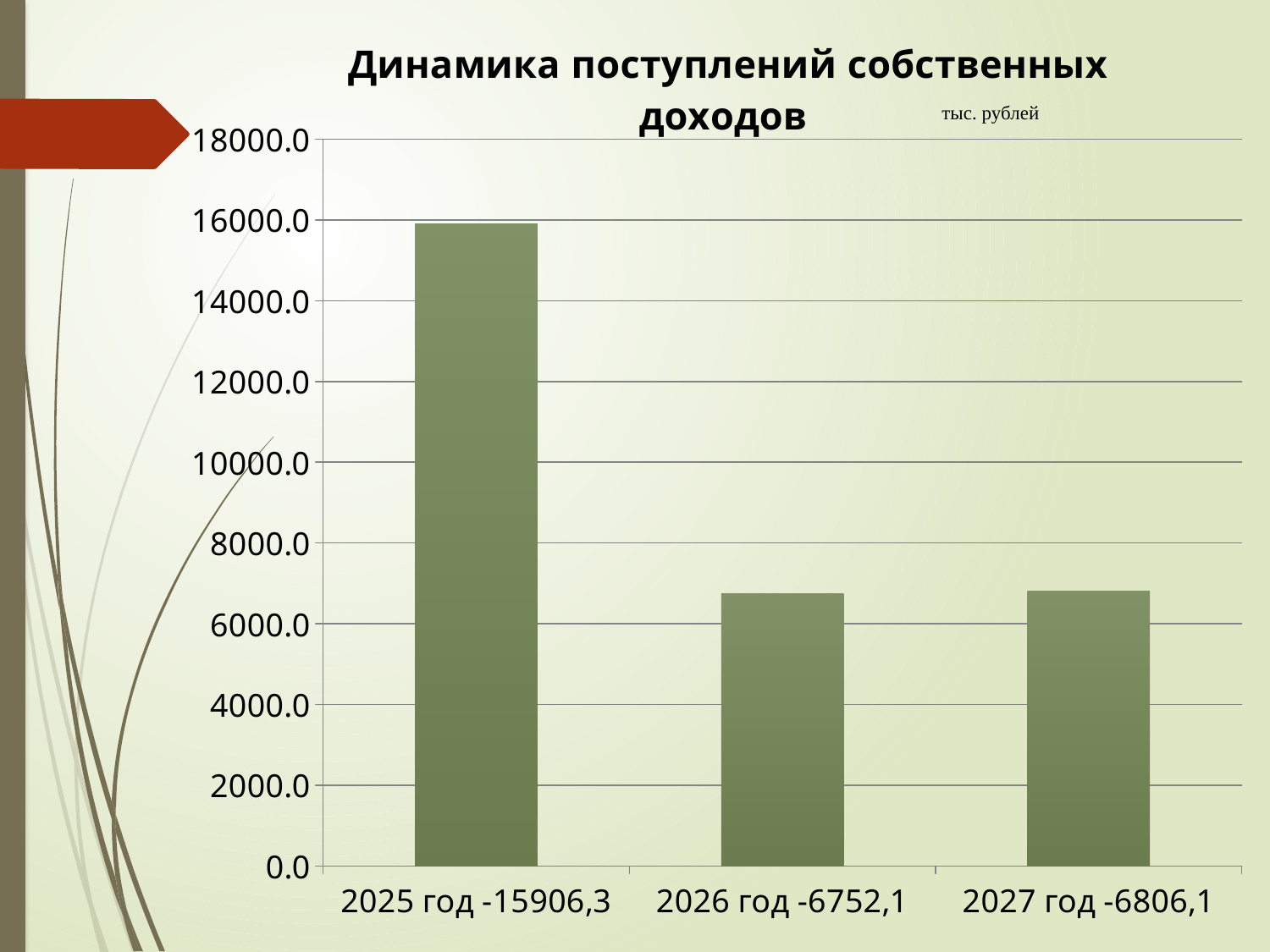
What is the value for 2026 год? 6752,1 What kind of chart is shown on the slide? bar chart Is the value for 2025 год greater or less than 14000? greater Which is larger, the value for 2026 год or 2027 год? 2027 год What is the value for 2027 год? 6806,1 What is the difference between the values for 2027 год and 2026 год? 54,0 What is the value for 2025 год? 15906,3 What unit is indicated next to the chart title? тыс. рублей What is the difference between the values for 2025 год and 2026 год? 9154,2 How many bars are shown in the chart? 3 Which year has the highest value? 2025 год Which year has the lowest value? 2026 год